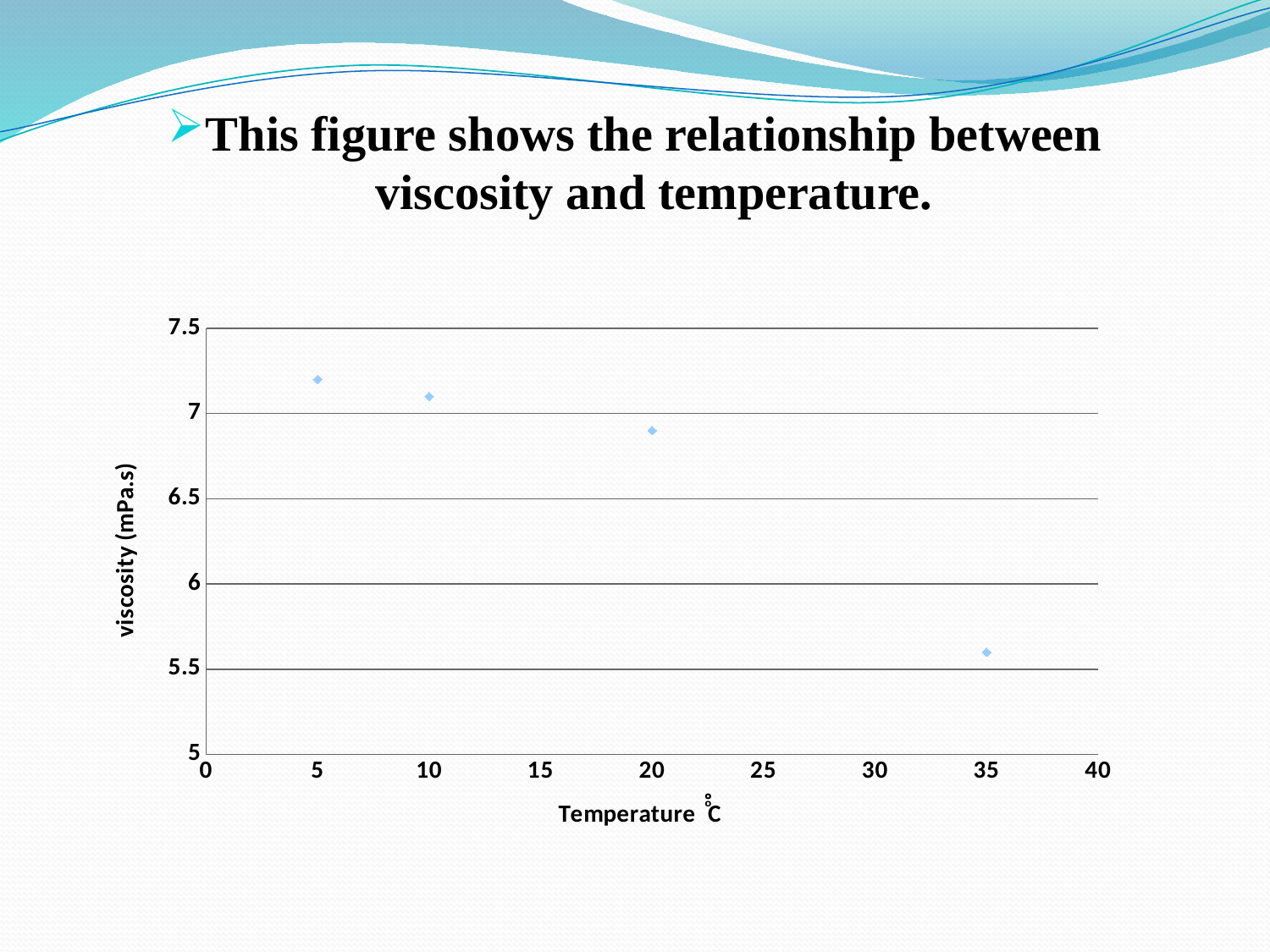
Which has the higher viscosity, the point at 5 °C or the point at 35 °C? 5 °C At which temperature is the viscosity lowest? 35 At which temperature is the viscosity highest? 5 Is the viscosity at 5 °C greater or less than 7? greater How many data points are plotted on the chart? 4 Is the viscosity at 10 °C greater or less than 6.5? greater What kind of chart is shown on the slide? scatter chart What is the label of the x axis? Temperature °C Is the viscosity at 35 °C greater or less than 6? less As temperature increases along the x axis, does viscosity rise or fall? fall What is the label of the y axis? viscosity (mPa.s)